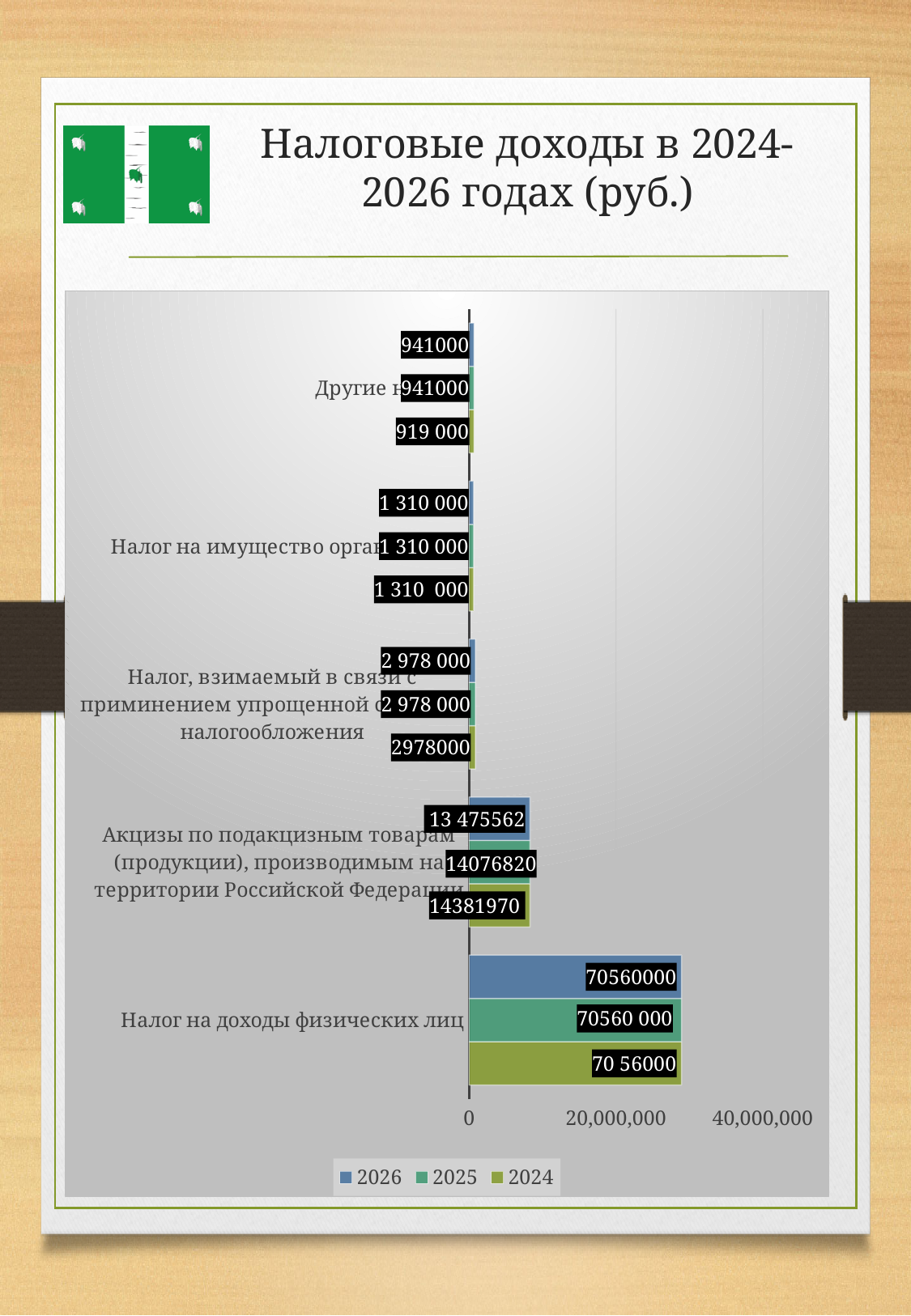
What is the 2026 value for 'Налог на доходы физических лиц'? 70560000 How many tax categories are plotted on the chart? 5 What is the 2026 value for 'Акцизы по подакцизным товарам (продукции), производимым на территории Российской Федерации'? 13 475562 Which category has the highest value in the 2026 series? Налог на доходы физических лиц For 'Акцизы по подакцизным товарам', which is larger: the 2024 value or the 2025 value? 2024 What is the 2024 value for 'Акцизы по подакцизным товарам (продукции), производимым на территории Российской Федерации'? 14381970 How many series does the chart legend list? 3 What is the 2025 value for 'Акцизы по подакцизным товарам (продукции), производимым на территории Российской Федерации'? 14076820 What entries are listed in the chart legend? 2026, 2025, 2024 What is the difference between the 2024 and 2025 values for 'Акцизы по подакцизным товарам'? 305150 What kind of chart is shown on the slide? Bar chart What is the 2026 value for the tax collected under the simplified taxation system ('Налог, взимаемый в связи с приминением упрощенной системы налогообложения')? 2 978 000